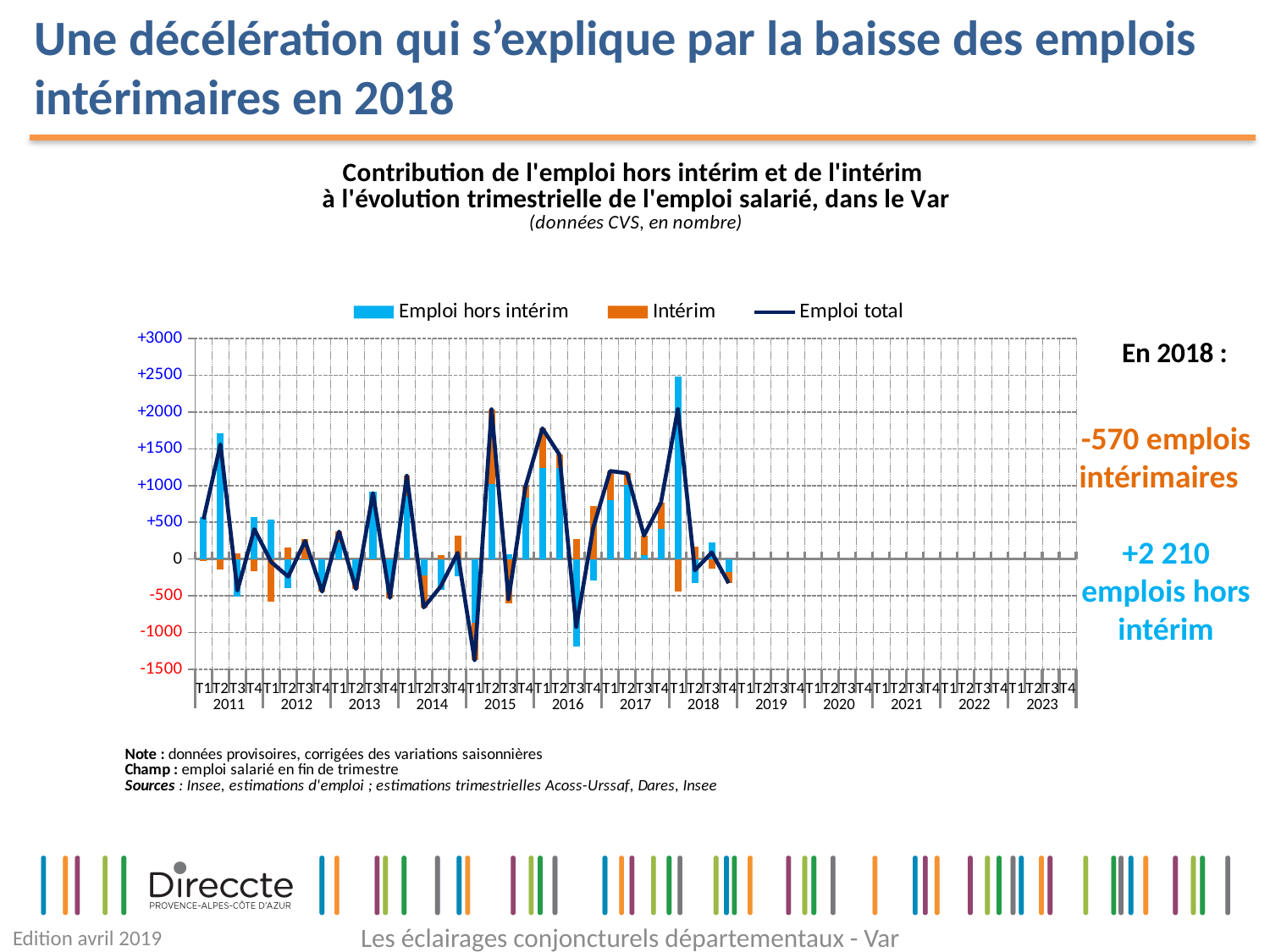
In which quarter does the Emploi total line reach its lowest point? T1 2015 In which quarter is the Emploi hors intérim bar the highest? T1 2018 Is the value of Emploi hors intérim in T2 2011 greater or less than +1500? greater How many years are labelled along the x axis? 13 Is the value of Emploi total in T1 2015 greater or less than -1000? less What kind of chart is shown on the slide? A bar chart combined with a line Which series is drawn as a line rather than bars? Emploi total How many series does the legend list? 3 What is the highest value shown on the vertical axis? +3000 Is the value of Emploi hors intérim in T3 2016 greater or less than -1000? less Which is larger, the Emploi hors intérim value in T1 2018 or in T2 2011? T1 2018